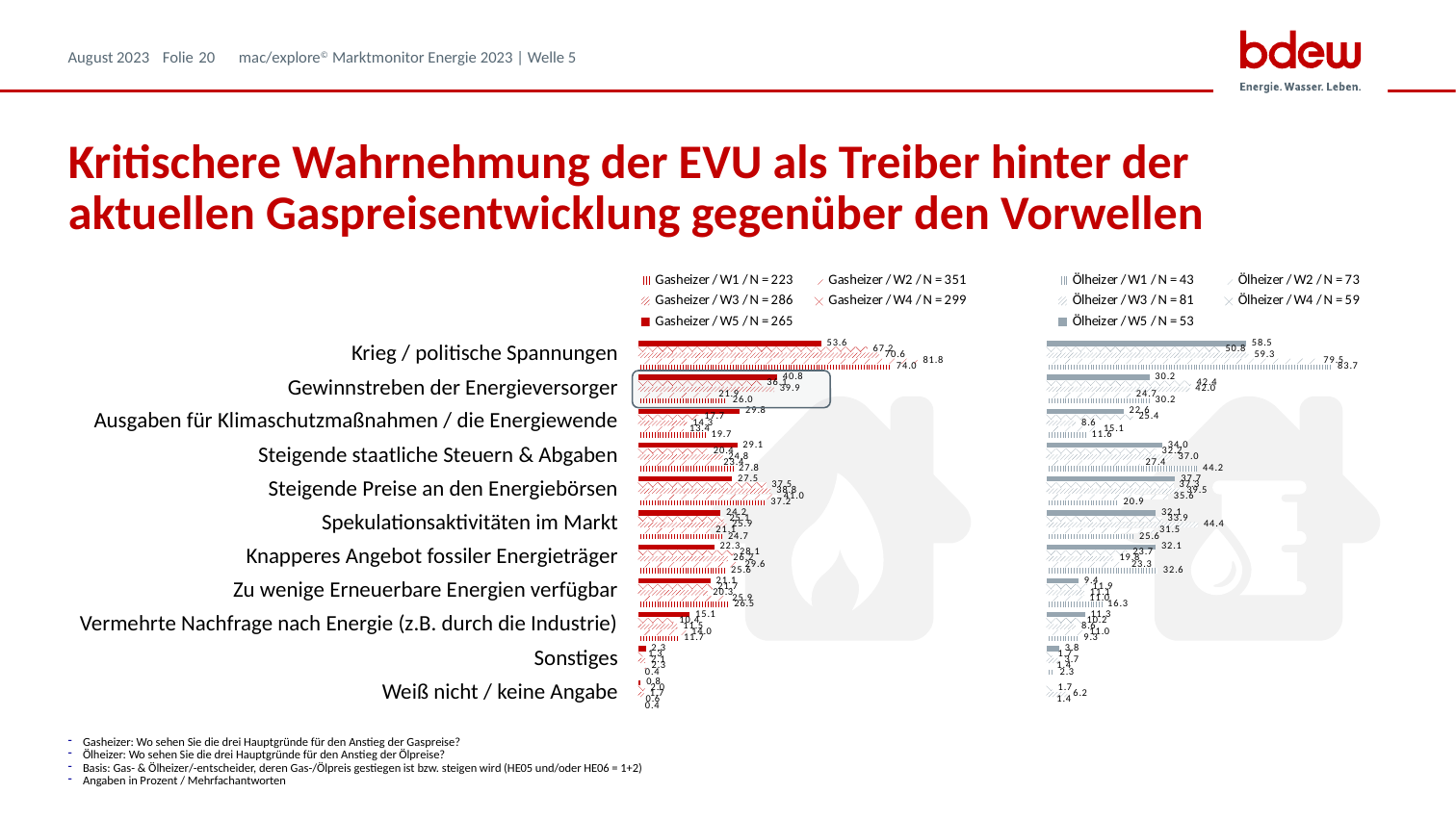
What type of chart is used on the left (Gasheizer) chart? bar chart For 'Krieg / politische Spannungen' in the W5 series, which chart shows the larger value: the left (Gasheizer) chart or the right (Ölheizer) chart? right (Ölheizer) chart On the left (Gasheizer) chart, what is the value for 'Krieg / politische Spannungen' in the Gasheizer / W5 series? 53.6 On the left (Gasheizer) chart, what is the value for 'Gewinnstreben der Energieversorger' in the Gasheizer / W5 series? 40.8 How many categories (reasons) are listed on the left (Gasheizer) chart? 11 How many series does the legend of the right (Ölheizer) chart list? 5 On the left (Gasheizer) chart, what is the value for 'Krieg / politische Spannungen' in the Gasheizer / W1 series? 74.0 On the right (Ölheizer) chart, what is the value for 'Krieg / politische Spannungen' in the Ölheizer / W1 series? 83.7 On the left (Gasheizer) chart, which category has the highest value in the Gasheizer / W5 series? Krieg / politische Spannungen On the right (Ölheizer) chart, what is the value for 'Krieg / politische Spannungen' in the Ölheizer / W5 series? 58.5 According to the legend of the left chart, what is the sample size (N) for Gasheizer / W2? 351 On the left (Gasheizer) chart, what is the difference between the W1 and W5 values for 'Krieg / politische Spannungen'? 20.4